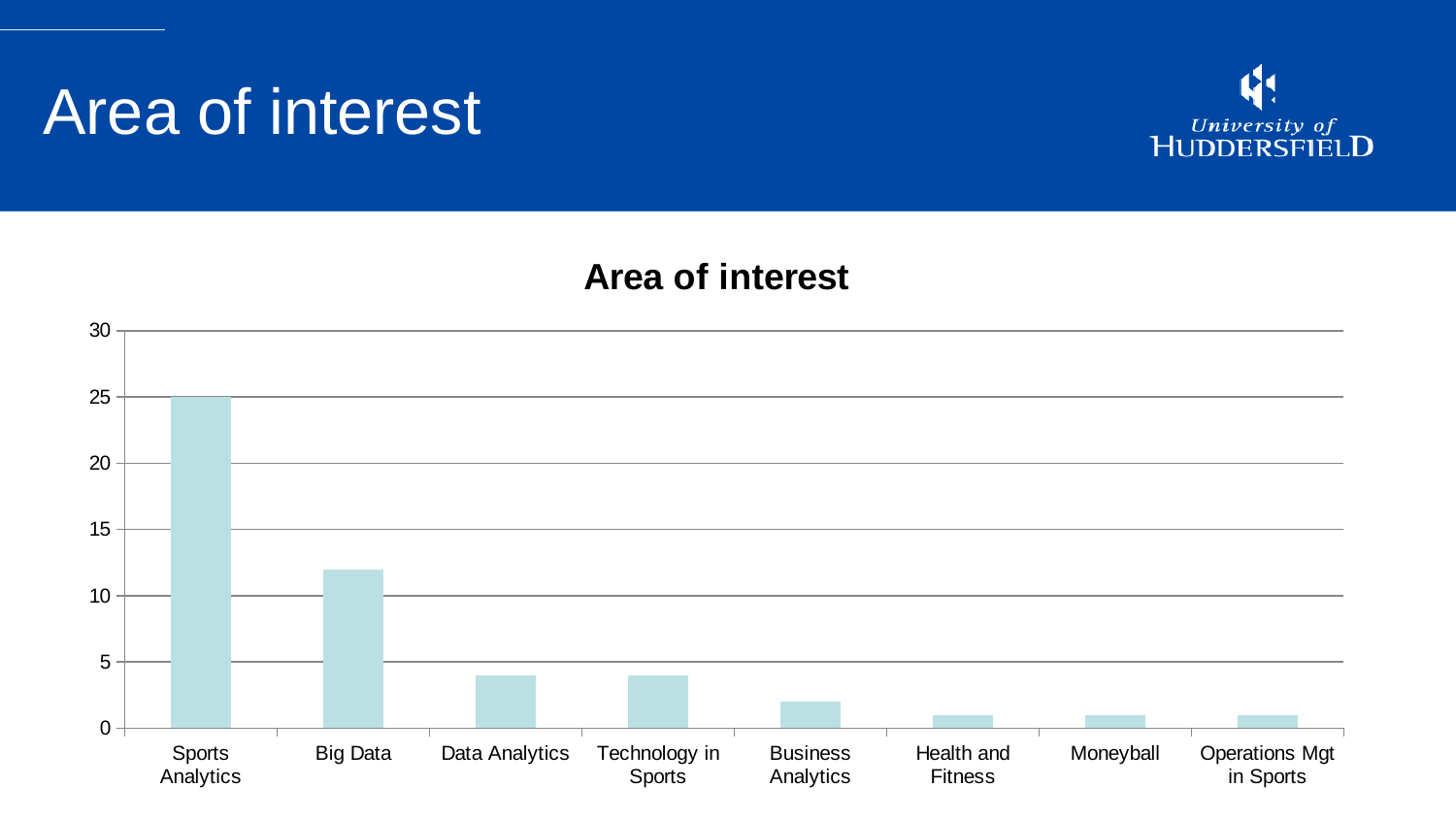
Is the value for Big Data greater or less than 10? greater Is the value for Data Analytics greater or less than 5? less Do the values generally rise or fall moving from left to right along the x axis? fall Is the value for Big Data greater or less than 15? less Which category has the highest value in the chart? Sports Analytics How many categories are shown on the x axis of the chart? 8 What type of chart is shown on the slide? bar chart Which is larger, the value for Big Data or the value for Data Analytics? Big Data What is the value for Sports Analytics? 25 Which is larger, the value for Sports Analytics or the value for Big Data? Sports Analytics What is the title of the chart? Area of interest